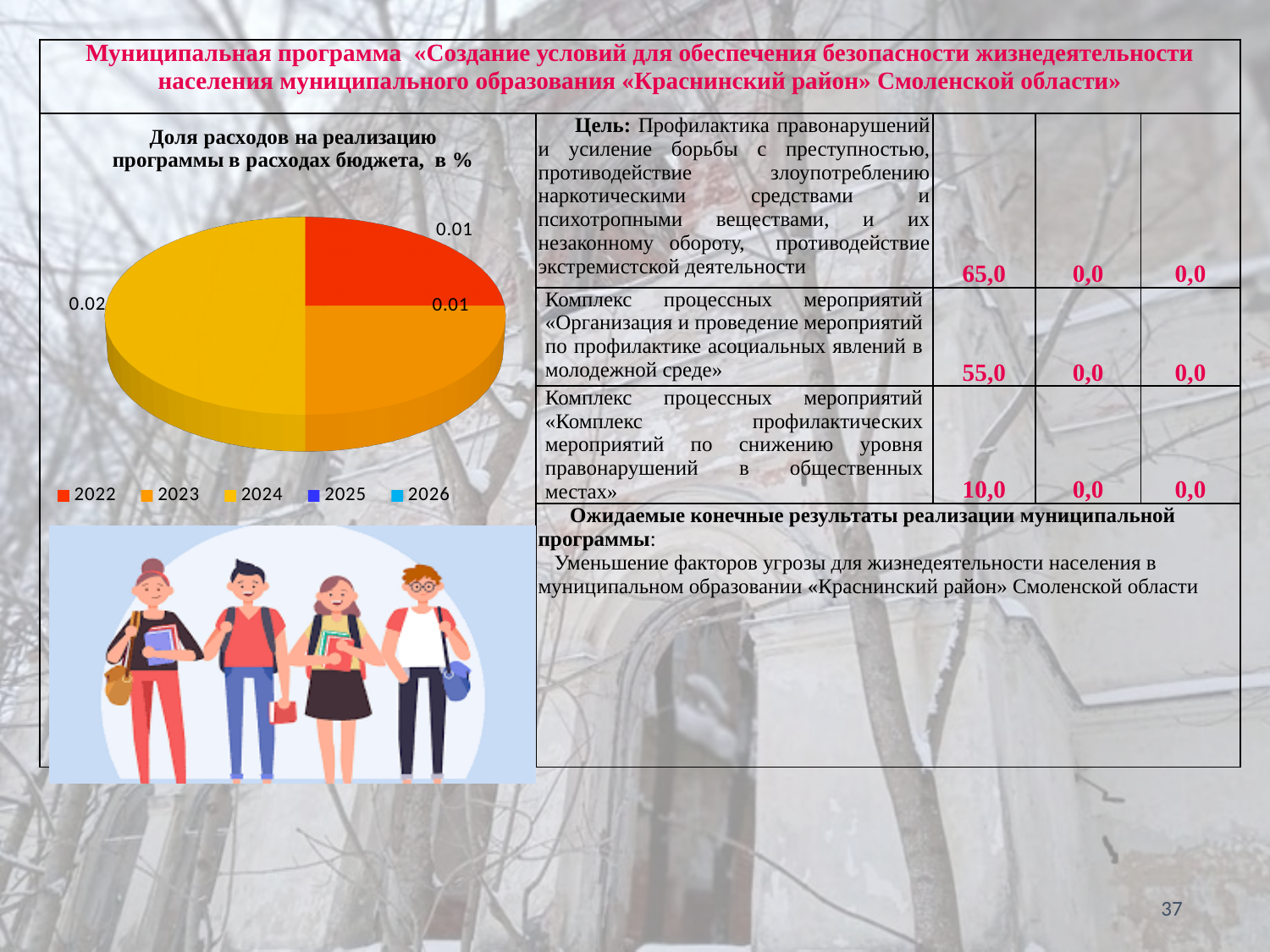
What is the title of the pie chart? Доля расходов на реализацию программы в расходах бюджета, в % Which year has the largest slice in the pie chart? 2024 What colour represents 2022 in the pie chart legend? red What value is shown for 2024 in the pie chart? 0.02 What kind of chart is shown on the slide? pie chart How many entries does the legend of the pie chart list? 5 What value is shown for 2023 in the pie chart? 0.01 How many slices with data labels are visible in the pie chart? 3 What value is shown for 2022 in the pie chart? 0.01 Which is larger in the pie chart, the value for 2024 or the value for 2022? 2024 What is the difference between the values for 2024 and 2023 in the pie chart? 0.01